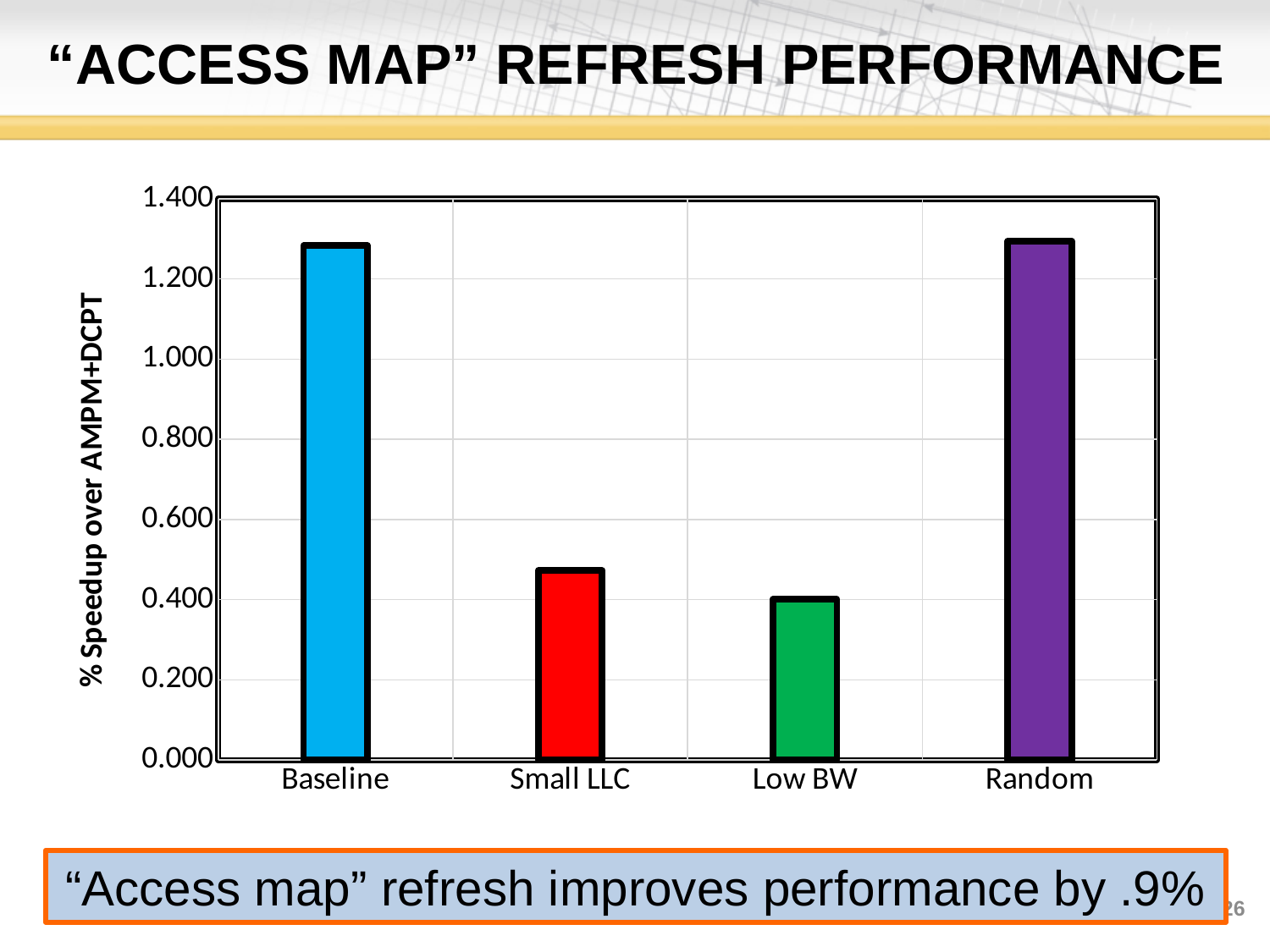
Is the value for Baseline greater or less than 1.200? greater Is the value for Random greater or less than 1.000? greater Which is larger, the value for Baseline or the value for Small LLC? Baseline What colour is the bar for Random? purple Which category has the lowest value in the chart? Low BW Is the value for Small LLC greater or less than 0.600? less What kind of chart is shown on the slide? bar chart How many categories are shown on the x axis of the chart? 4 Which is larger, the value for Small LLC or the value for Low BW? Small LLC What is the label of the y axis of the chart? % Speedup over AMPM+DCPT